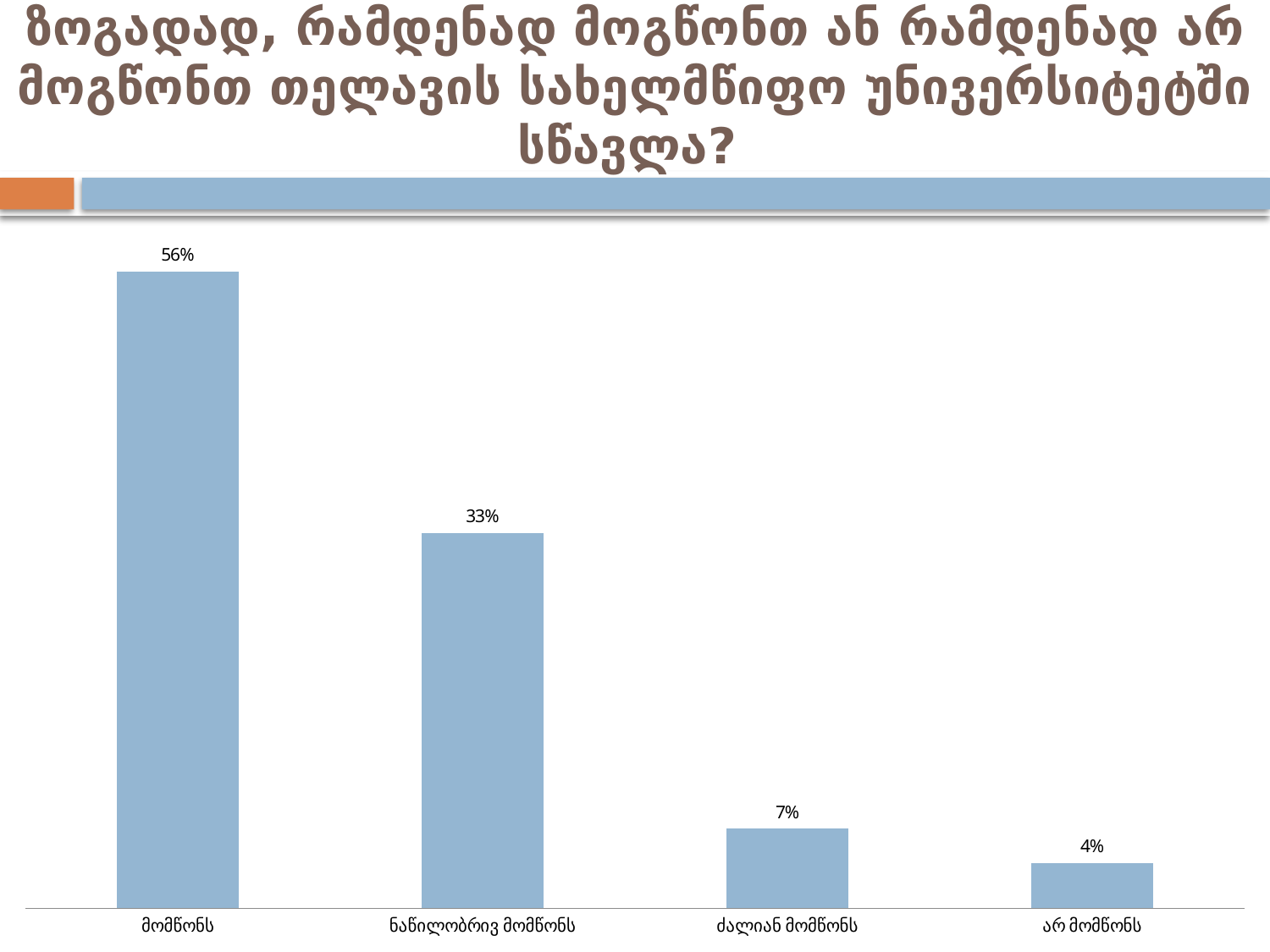
Which category has the highest value? მომწონს Which category has the lowest value? არ მომწონს How many categories are shown in the chart? 4 Which is larger, the value for ნაწილობრივ მომწონს or the value for ძალიან მომწონს? ნაწილობრივ მომწონს Do the values rise or fall from left to right along the x axis? Fall What is the difference between the values for ძალიან მომწონს and არ მომწონს? 3% What is the value for მომწონს? 56% What is the value for ნაწილობრივ მომწონს? 33% What is the value for ძალიან მომწონს? 7% What is the value for არ მომწონს? 4% What is the difference between the values for მომწონს and ნაწილობრივ მომწონს? 23% What kind of chart is shown on the slide? Bar chart